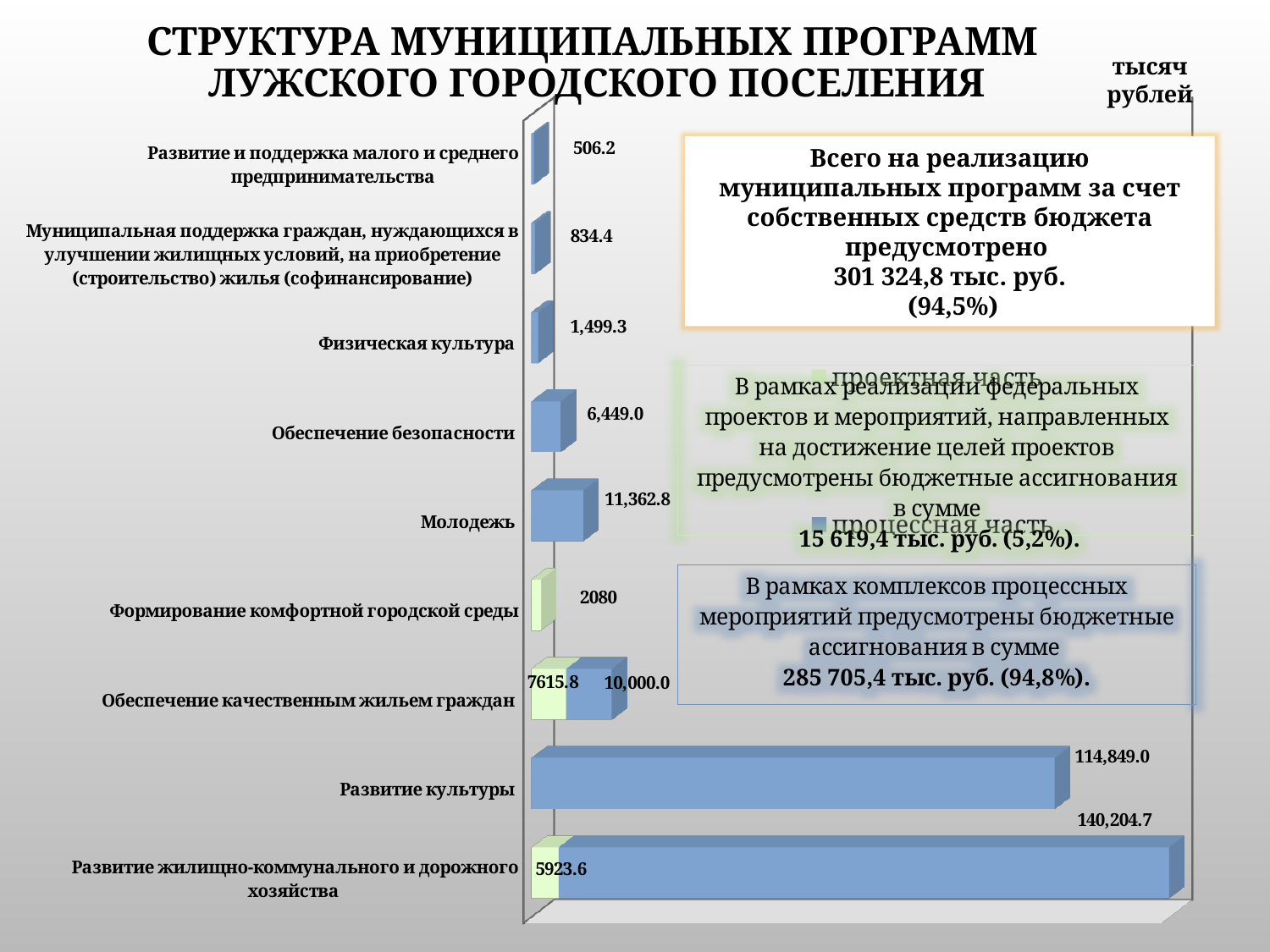
What is the проектная часть value for Обеспечение качественным жильем граждан? 7615.8 Which category has the smallest value? Развитие и поддержка малого и среднего предпринимательства What is the difference between the процессная часть values for Развитие жилищно-коммунального и дорожного хозяйства and Развитие культуры? 25,355.7 What is the value for Физическая культура? 1,499.3 How many series does the legend list? 2 What is the процессная часть value for Развитие жилищно-коммунального и дорожного хозяйства? 140,204.7 What is the value for Молодежь? 11,362.8 What is the value for Развитие культуры? 114,849.0 Which is larger: the value for Обеспечение безопасности or the value for Молодежь? Молодежь How many categories are shown on the chart? 9 What kind of chart is shown on the slide? Bar chart Which category has the largest bar? Развитие жилищно-коммунального и дорожного хозяйства